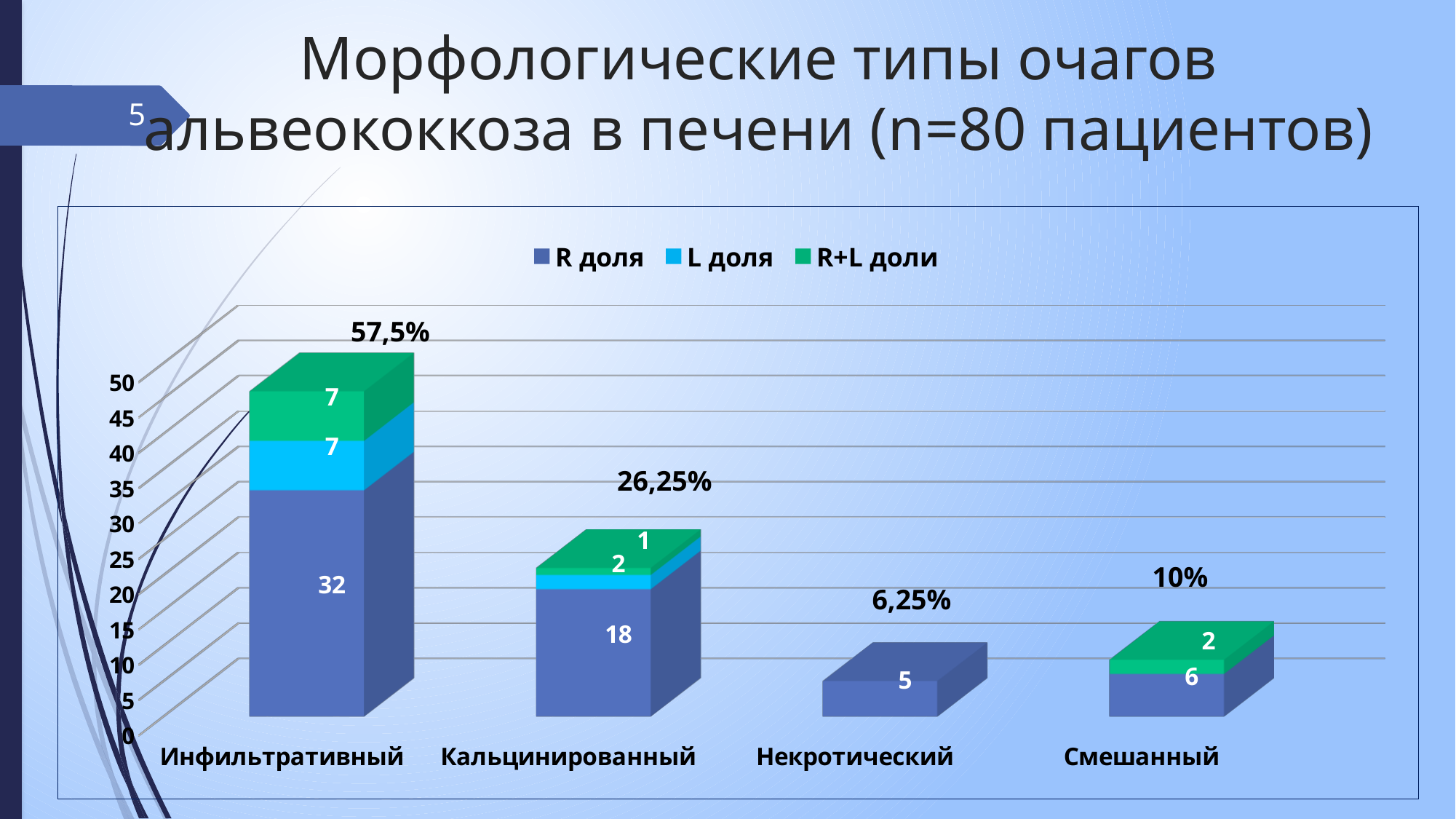
What is the value of the R доля series for the Инфильтративный category? 32 What percentage label is shown above the Некротический bar? 6,25% What is the value of the L доля series for the Кальцинированный category? 2 How many categories are shown on the x axis? 4 What is the difference between the R доля values for Инфильтративный and Кальцинированный? 14 Which is larger: the R доля value for Смешанный or the R доля value for Некротический? Смешанный What percentage label is shown above the Кальцинированный bar? 26,25% Which category has the tallest stacked bar? Инфильтративный What is the total of the stacked bar for the Инфильтративный category? 46 What is the value of the R+L доли series for the Смешанный category? 2 How many series does the legend list? 3 Which category has the shortest stacked bar? Некротический